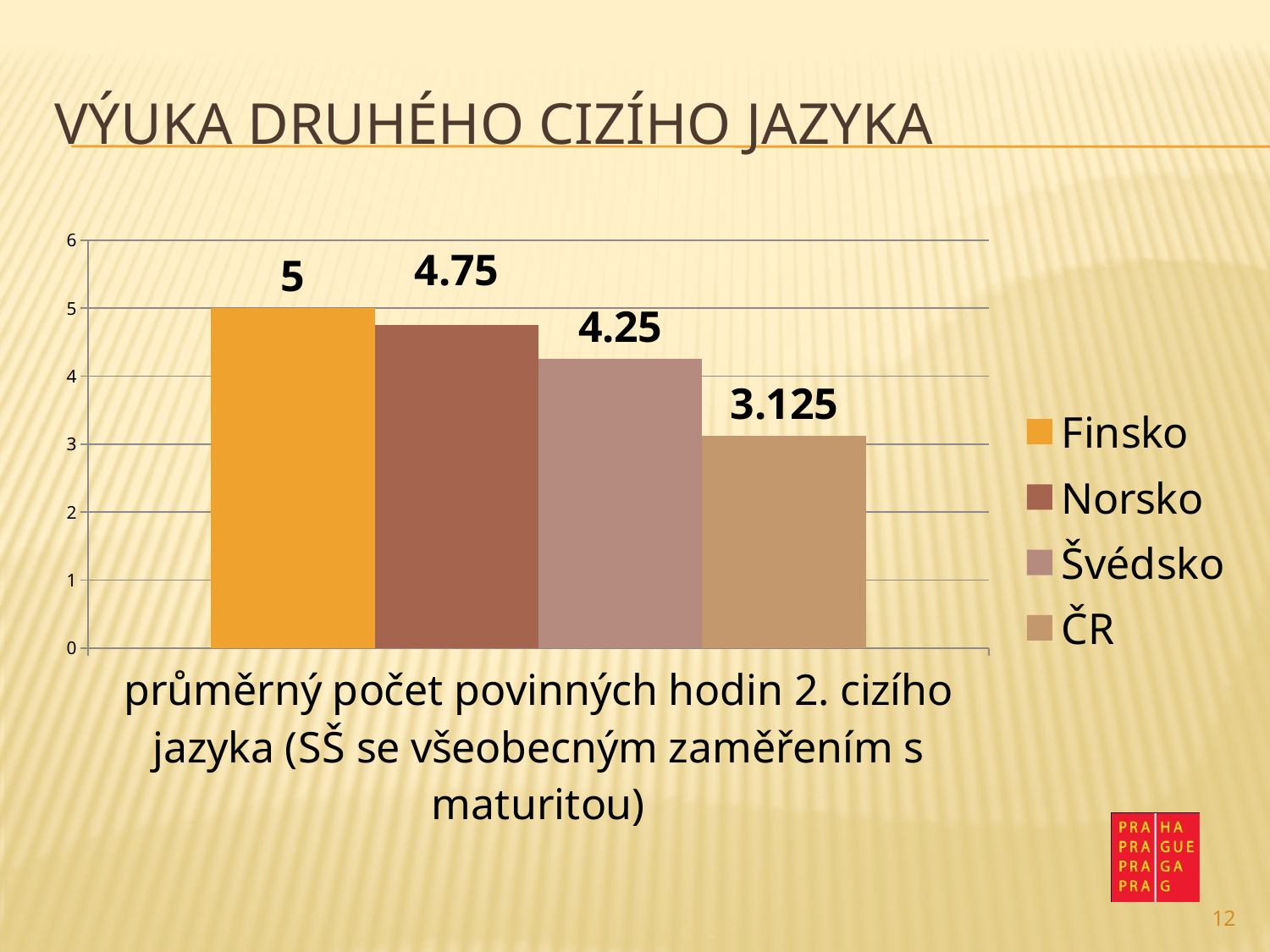
Do the values rise or fall from left to right across the bars? fall Which country has the lowest value? ČR What is the value for Finsko? 5 Which is larger, the value for Švédsko or the value for ČR? Švédsko What is the value for Norsko? 4.75 What kind of chart is shown on the slide? bar chart What is the difference between the values for Norsko and Švédsko? 0.5 Which country has the highest value? Finsko What is the value for ČR? 3.125 How many countries are shown in the chart? 4 What is the difference between the values for Finsko and ČR? 1.875 What is the value for Švédsko? 4.25